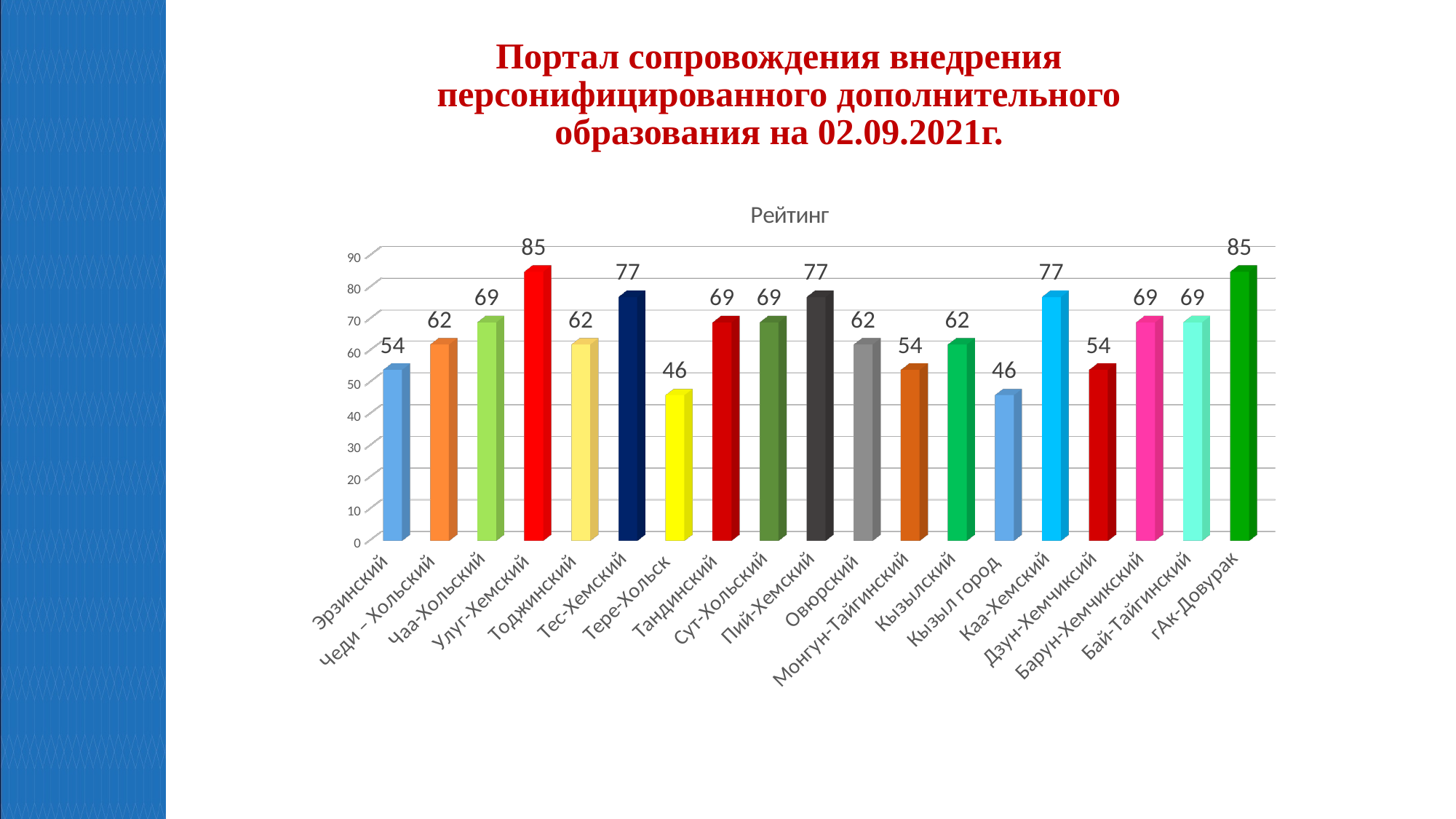
What is the difference between the values for Улуг-Хемский and Кызыл город? 39 What is the value for Каа-Хемский? 77 What is the value for Монгун-Тайгинский? 54 What is the lowest value shown in the chart? 46 What is the value for Тере-Хольск? 46 Which has a larger value, Пий-Хемский or Овюрский? Пий-Хемский What is the value for Улуг-Хемский? 85 What is the difference between the values for Тес-Хемский and Эрзинский? 23 What is the title of the chart? Рейтинг Is the value for Кызылский greater or less than 50? greater How many categories are shown on the x axis? 19 What is the highest value shown in the chart? 85